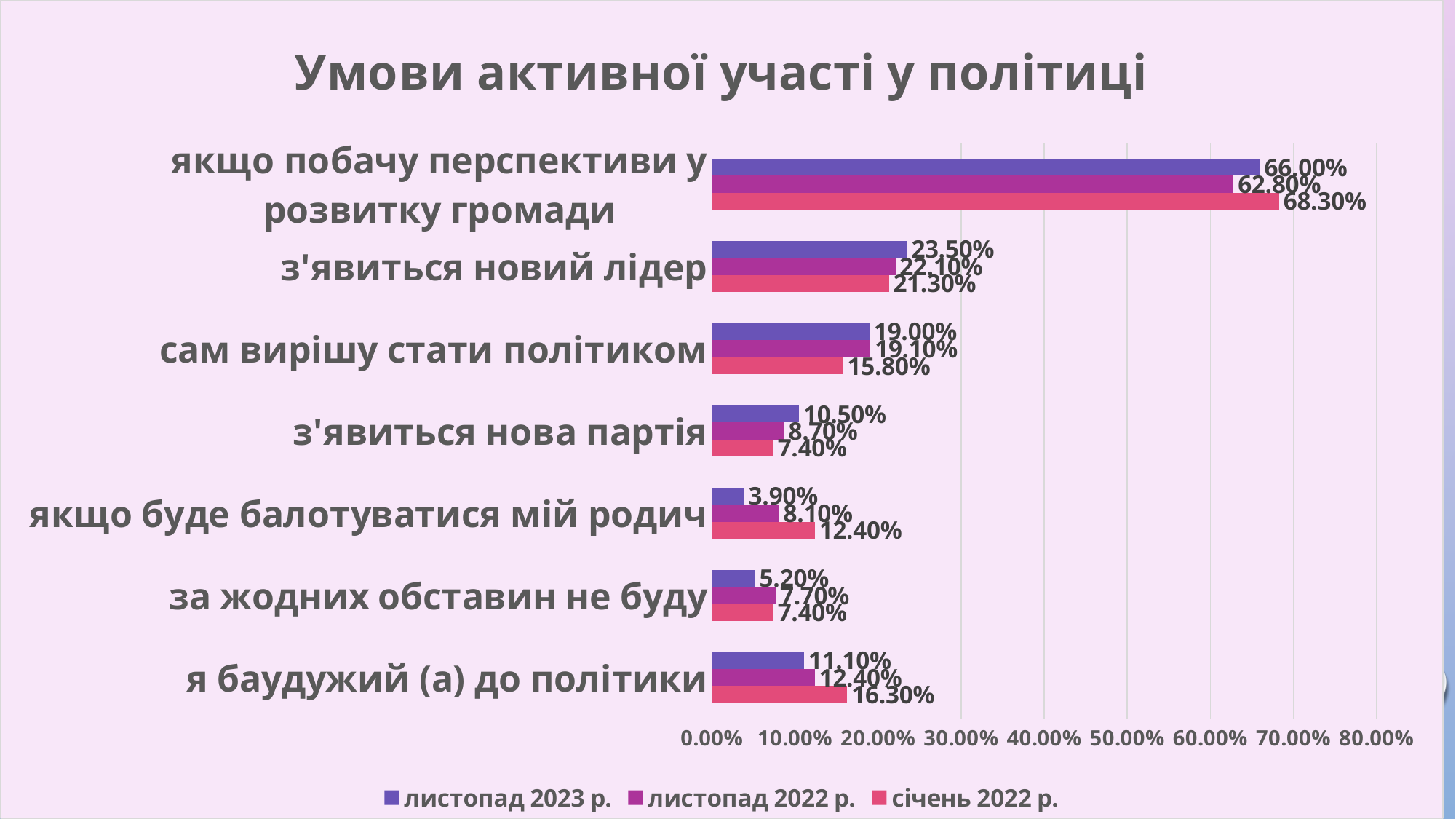
What is the title of the chart? Умови активної участі у політиці What is the value for 'якщо буде балотуватися мій родич' in the 'січень 2022 р.' series? 12.40% What type of chart is shown on the slide? bar chart What is the value for 'з'явиться новий лідер' in the 'листопад 2023 р.' series? 23.50% How many categories are shown on the chart? 7 Which category has the highest value in the 'листопад 2023 р.' series? якщо побачу перспективи у розвитку громади For 'я баудужий (а) до політики', which series has the larger value: 'листопад 2023 р.' or 'січень 2022 р.'? січень 2022 р. Is the 'листопад 2022 р.' value for 'якщо побачу перспективи у розвитку громади' greater or less than 60.00%? greater What is the difference between the 'січень 2022 р.' and 'листопад 2022 р.' values for 'якщо побачу перспективи у розвитку громади'? 5.50% What is the value for 'за жодних обставин не буду' in the 'листопад 2022 р.' series? 7.70% Which category has the lowest value in the 'листопад 2023 р.' series? якщо буде балотуватися мій родич How many series does the legend list? 3